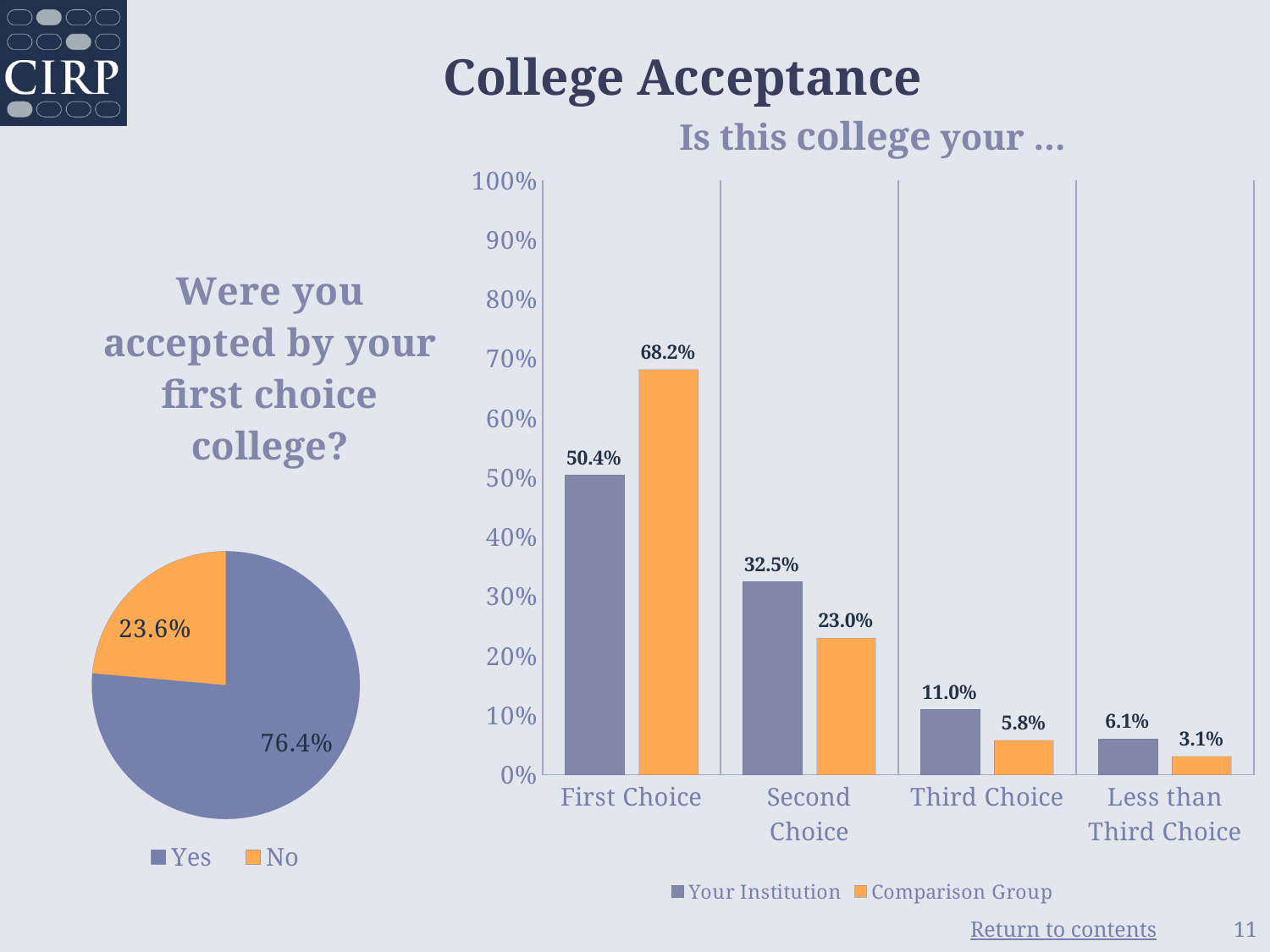
In the bar chart 'Is this college your ...', what is the value for Your Institution for Less than Third Choice? 6.1% In the bar chart 'Is this college your ...', what is the value for Your Institution for First Choice? 50.4% In the bar chart 'Is this college your ...', what is the difference between the Comparison Group and Your Institution values for First Choice? 17.8% In the bar chart 'Is this college your ...', how many series does the legend list? 2 In the bar chart 'Is this college your ...', which category has the highest Comparison Group value? First Choice In the bar chart 'Is this college your ...', which is larger for Third Choice: Your Institution or Comparison Group? Your Institution In the bar chart 'Is this college your ...', which category has the lowest Your Institution value? Less than Third Choice In the pie chart 'Were you accepted by your first choice college?', what share of respondents answered Yes? 76.4% What kind of chart is the chart on the right side of the slide? Bar chart In the pie chart 'Were you accepted by your first choice college?', how many slices are there? 2 In the bar chart 'Is this college your ...', what is the value for Comparison Group for Second Choice? 23.0% In the pie chart 'Were you accepted by your first choice college?', what is the value for No? 23.6%